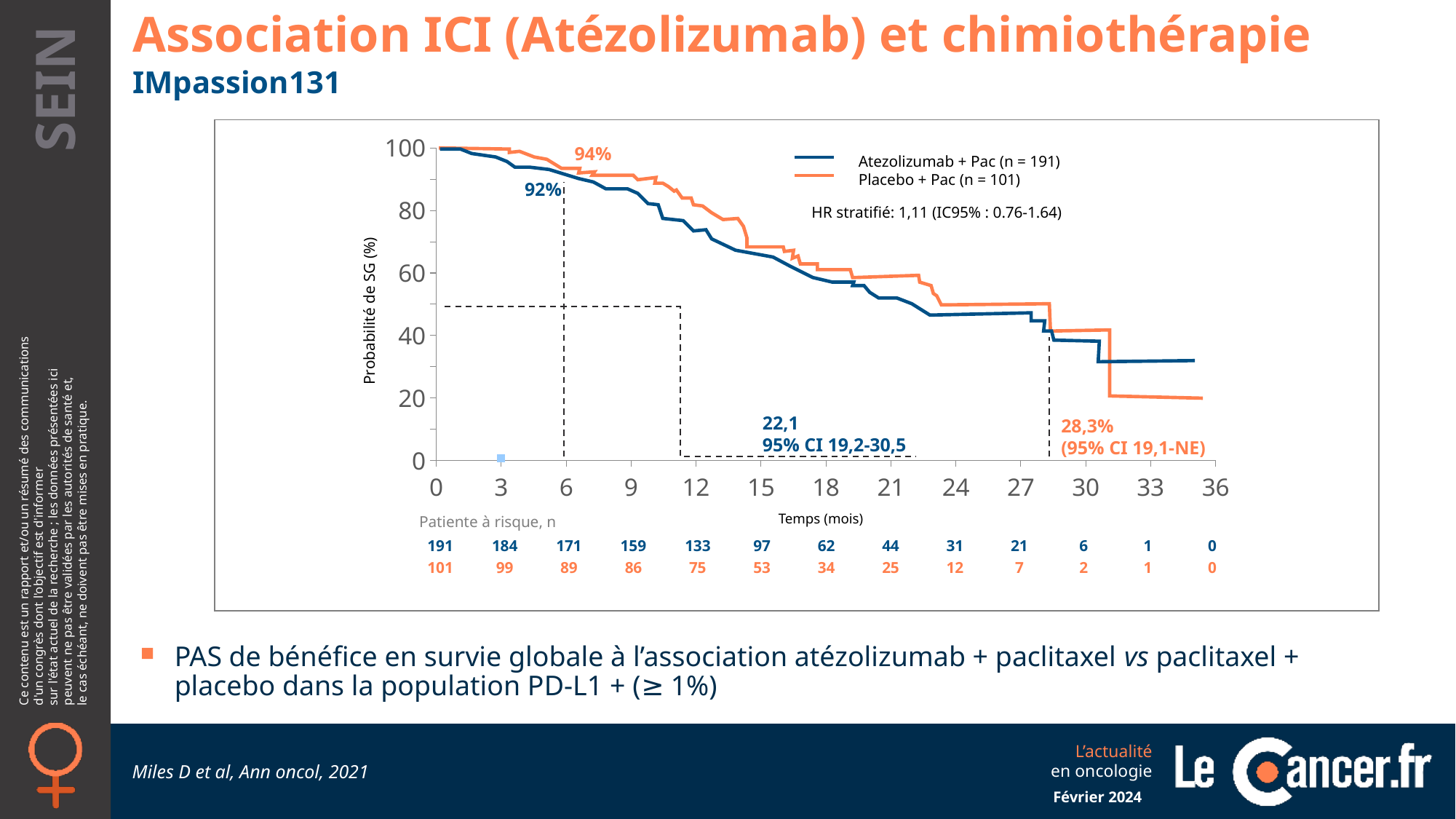
What is the stratified hazard ratio (HR stratifié) shown on the chart? 1,11 What is the labelled survival probability for Placebo + Pac at 6 months? 94% Is the value for Placebo + Pac at 30 months greater or less than 60? less How many Placebo + Pac patients are at risk at 15 months? 53 Which arm has the higher labelled survival probability at 6 months, Placebo + Pac or Atezolizumab + Pac? Placebo + Pac How many series does the legend list? 2 What kind of chart is shown on the slide? line chart What is the difference between the labelled 6-month survival probabilities of the Placebo + Pac and Atezolizumab + Pac arms? 2% What is the median overall survival value labelled for the Atezolizumab + Pac arm? 22,1 How many Atezolizumab + Pac patients are at risk at 12 months? 133 What is the labelled survival probability for Atezolizumab + Pac at 6 months? 92% Do the survival curves rise or fall as time (months) increases? fall